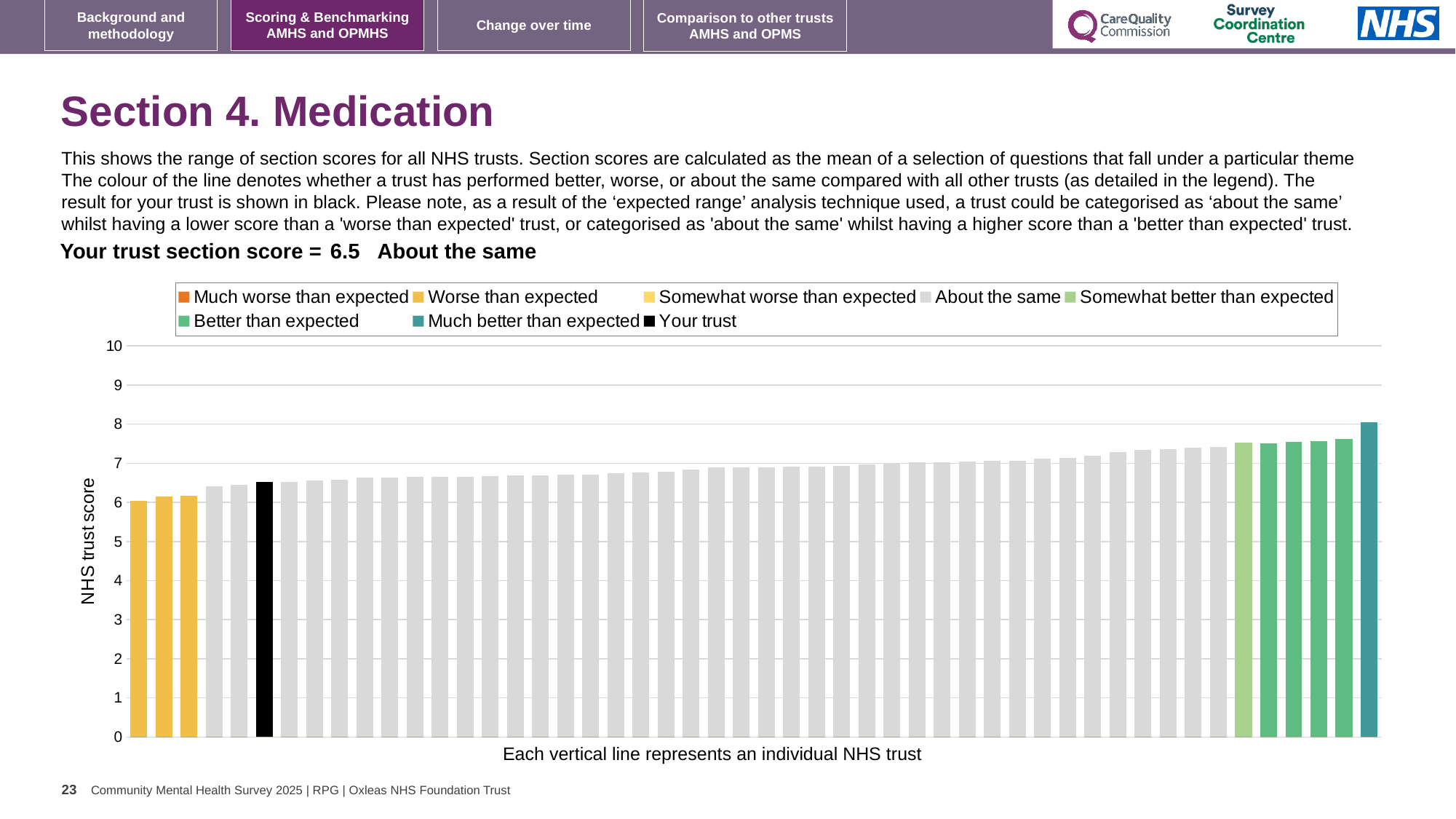
Do the bar values rise or fall from left to right along the x axis? rise Is the value of the black bar (your trust) greater or less than 6? greater Which legend category does the tallest bar belong to? Much better than expected How many entries does the chart legend list? 8 Is the value of the shortest bar greater or less than 7? less What is the label on the vertical axis of the chart? NHS trust score What is the section score for your trust shown on the slide? 6.5 Which category is your trust's section score placed in, according to the text above the chart? About the same What kind of chart is shown on the slide? bar chart Is the value of the black bar (your trust) greater or less than 7? less How many bars are coloured teal (Much better than expected)? 1